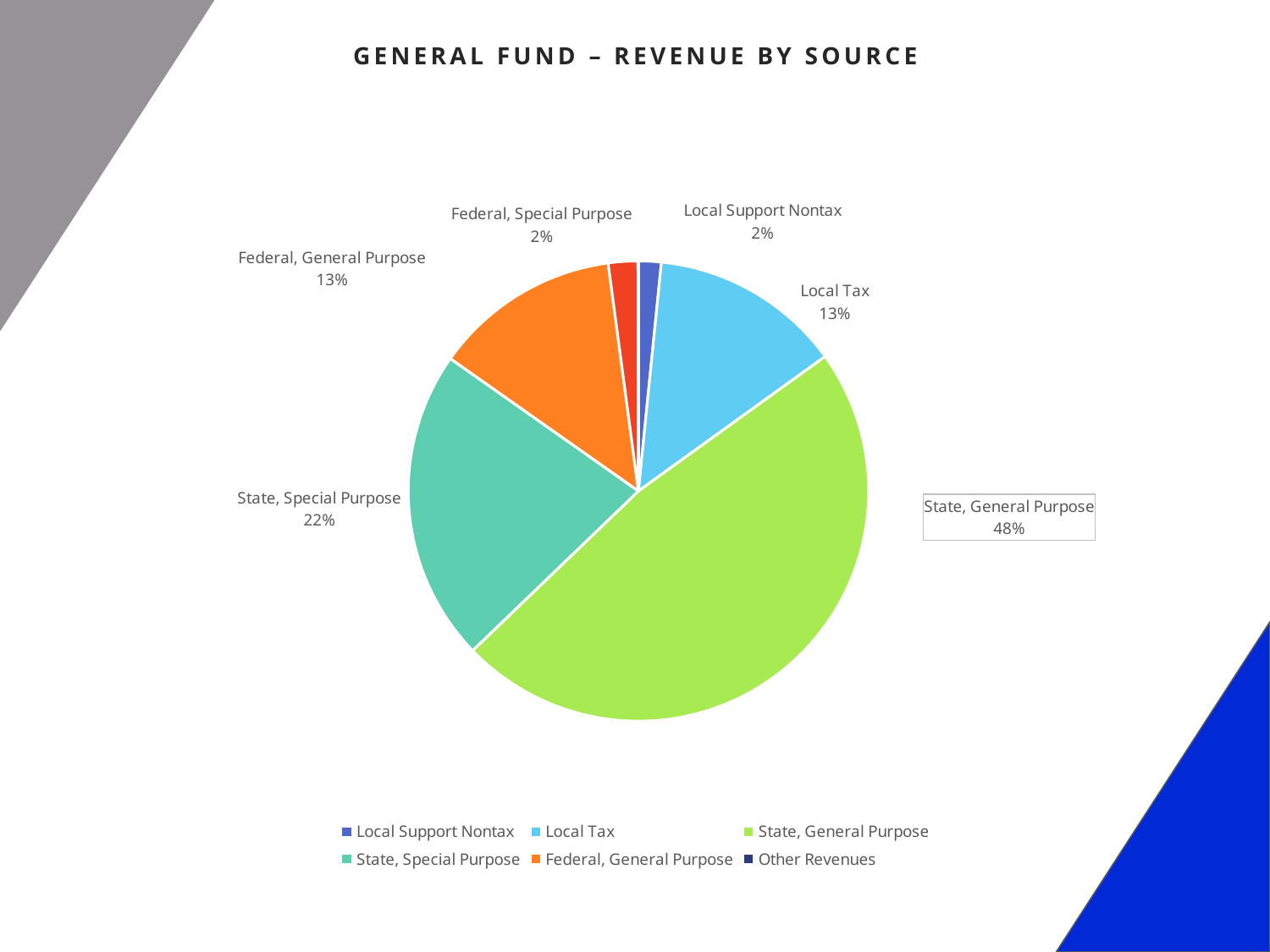
What type of chart is shown on the slide? Pie chart What is the difference in percentage points between State, General Purpose and State, Special Purpose? 26 percentage points What percentage is shown for State, Special Purpose? 22% Which revenue source has the largest slice of the pie? State, General Purpose What percentage is shown for Local Support Nontax? 2% How many entries does the legend list? 6 What share of revenue comes from State, General Purpose? 48% What is the title of the chart? GENERAL FUND – REVENUE BY SOURCE What percentage is shown for Federal, General Purpose? 13% What percentage is shown for Local Tax? 13% Which is larger, State, Special Purpose or Local Tax? State, Special Purpose